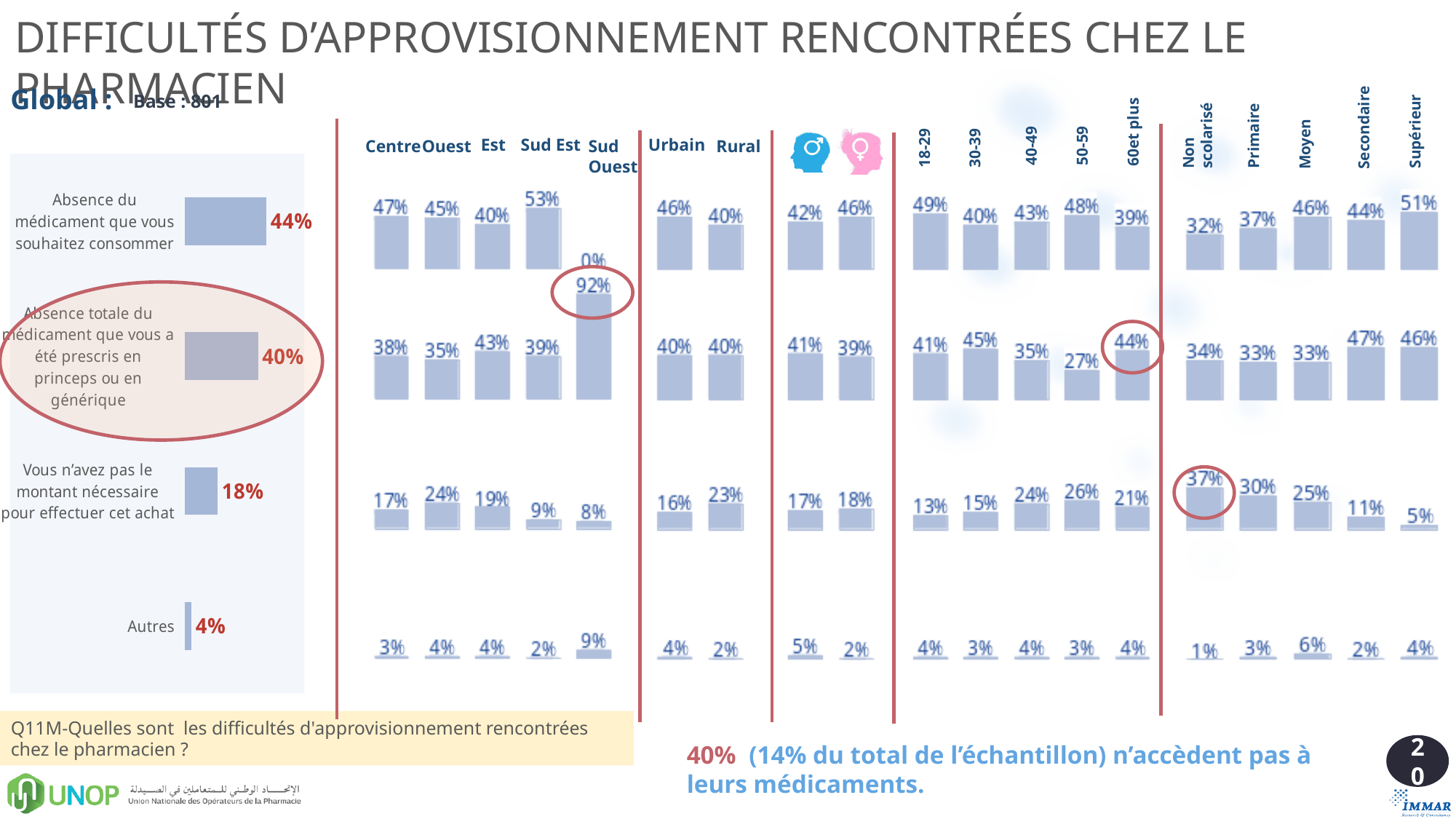
In the Global chart on the left, which category has the lowest value? Autres In the Global chart on the left, what is the difference between "Absence du médicament que vous souhaitez consommer" and "Vous n'avez pas le montant nécessaire pour effectuer cet achat"? 26% How many categories does the Global chart on the left show? 4 In the regional breakdown, which region has the highest value in the top row ("Absence du médicament que vous souhaitez consommer")? Sud Est In the regional breakdown, what is the value for Sud Ouest in the row "Absence totale du médicament que vous a été prescris en princeps ou en générique"? 92% In the Global chart on the left, what is the value for "Absence du médicament que vous souhaitez consommer"? 44% In the education breakdown, what is the value for "Non scolarisé" in the row "Vous n'avez pas le montant nécessaire pour effectuer cet achat"? 37% In the education breakdown, which level has the highest value in the top row ("Absence du médicament que vous souhaitez consommer")? Supérieur What kind of chart is the Global chart on the left? Bar chart In the Urbain/Rural breakdown, which is larger for "Vous n'avez pas le montant nécessaire pour effectuer cet achat": Urbain or Rural? Rural What is the base (sample size) shown for the Global chart? 801 In the age breakdown, what is the value for 50-59 in the row "Absence totale du médicament que vous a été prescris en princeps ou en générique"? 27%